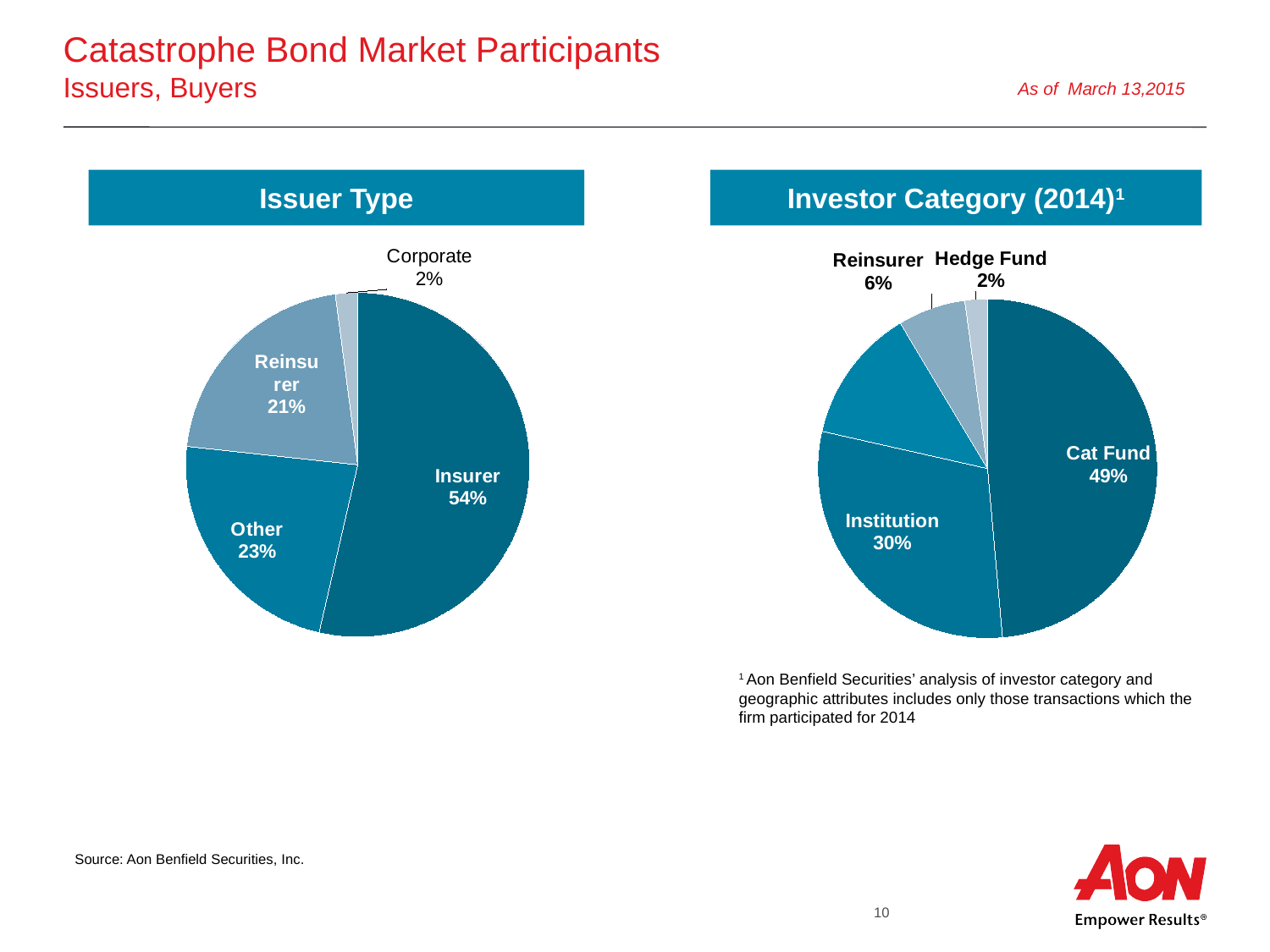
In the Investor Category (2014) chart, which is larger, Reinsurer or Hedge Fund? Reinsurer What kind of chart is the Investor Category (2014) chart? Pie chart In the Issuer Type chart, what share of the pie is Reinsurer? 21% In the Investor Category (2014) chart, what is the difference in percentage points between Cat Fund and Institution? 19 In the Investor Category (2014) chart, what share of the pie is Institution? 30% In the Investor Category (2014) chart, what share of the pie is Cat Fund? 49% What is the title of the chart on the left side of the slide? Issuer Type In the Issuer Type chart, what is the difference in percentage points between Other and Reinsurer? 2 In the Issuer Type chart, which category has the largest share? Insurer In the Issuer Type chart, which category has the smallest share? Corporate In the Issuer Type chart, how many categories are shown? 4